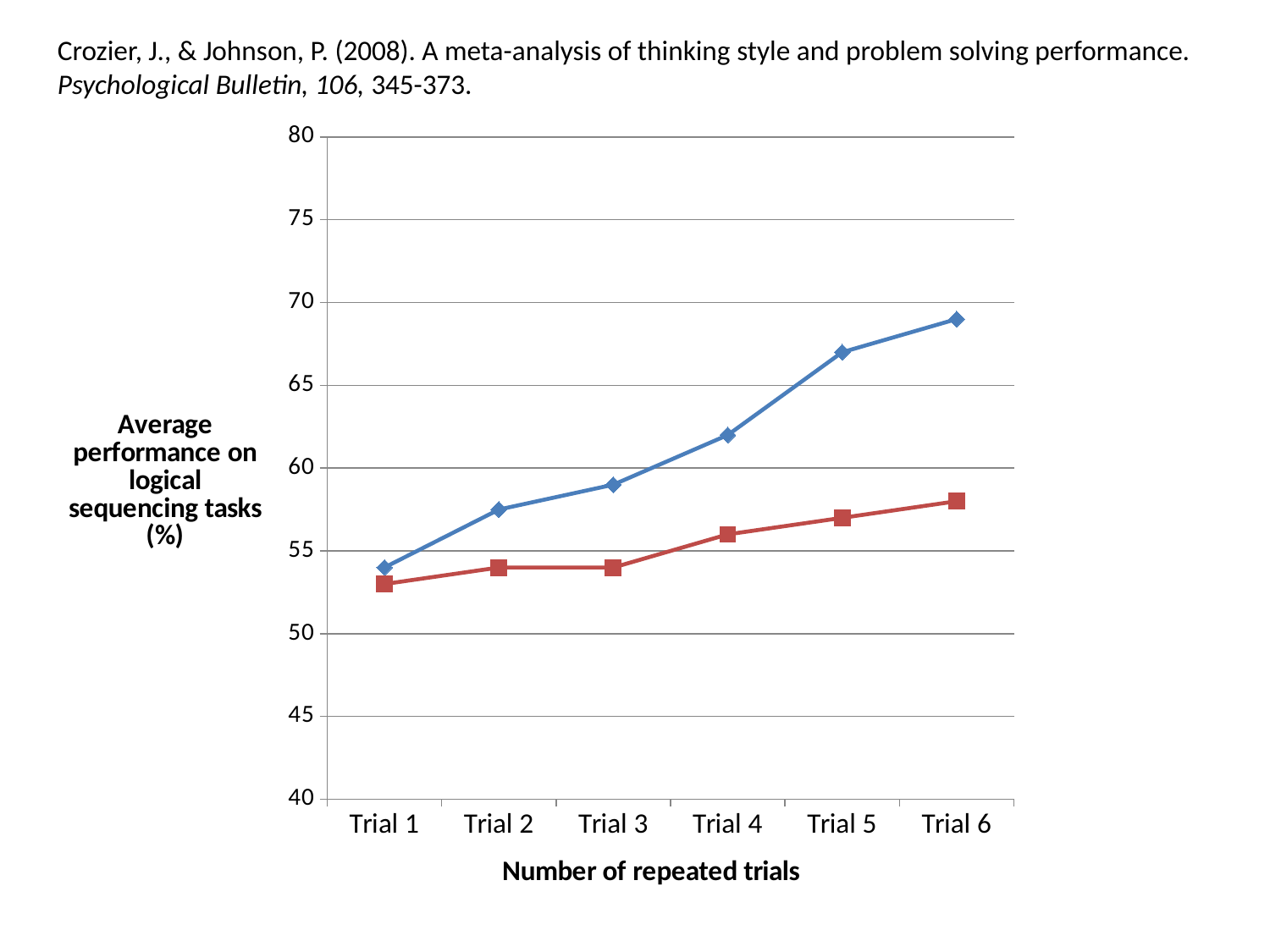
At Trial 5, which line has the higher value, the blue line or the red line? The blue line Is the value of the blue line at Trial 4 greater or less than 60? greater Is the value of the blue line at Trial 6 greater or less than 65? greater Do the values of the blue line rise or fall from Trial 1 to Trial 6? Rise At which trial does the red line reach its highest value? Trial 6 Is the value of the blue line at Trial 1 greater or less than 55? less What kind of chart is shown on the slide? Line chart What is the title of the x axis? Number of repeated trials How many lines (data series) are plotted on the chart? 2 What is the title of the y axis? Average performance on logical sequencing tasks (%) How many trials are shown along the x axis? 6